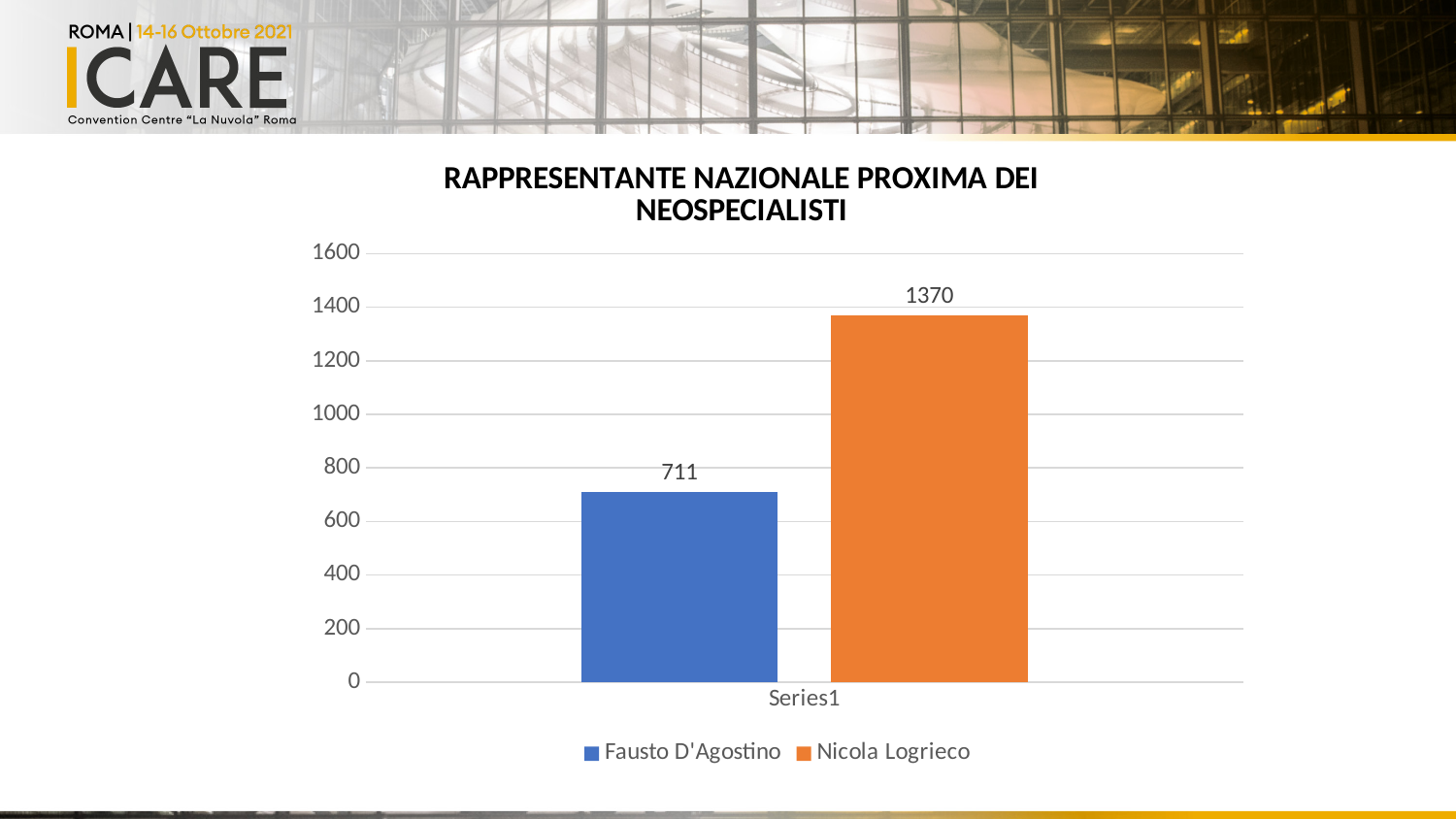
What colour is the bar for Nicola Logrieco? Orange What is the difference between the values for Nicola Logrieco and Fausto D'Agostino? 659 Which candidate has the highest value? Nicola Logrieco Is the value for Nicola Logrieco greater or less than 1200? greater What value is shown for Fausto D'Agostino? 711 Is the value for Fausto D'Agostino greater or less than 800? less What kind of chart is shown on the slide? Bar chart What is the title of the chart? RAPPRESENTANTE NAZIONALE PROXIMA DEI NEOSPECIALISTI Which candidate has the lowest value? Fausto D'Agostino How many series does the legend list? 2 Which is larger, the value for Fausto D'Agostino or the value for Nicola Logrieco? Nicola Logrieco What value is shown for Nicola Logrieco? 1370